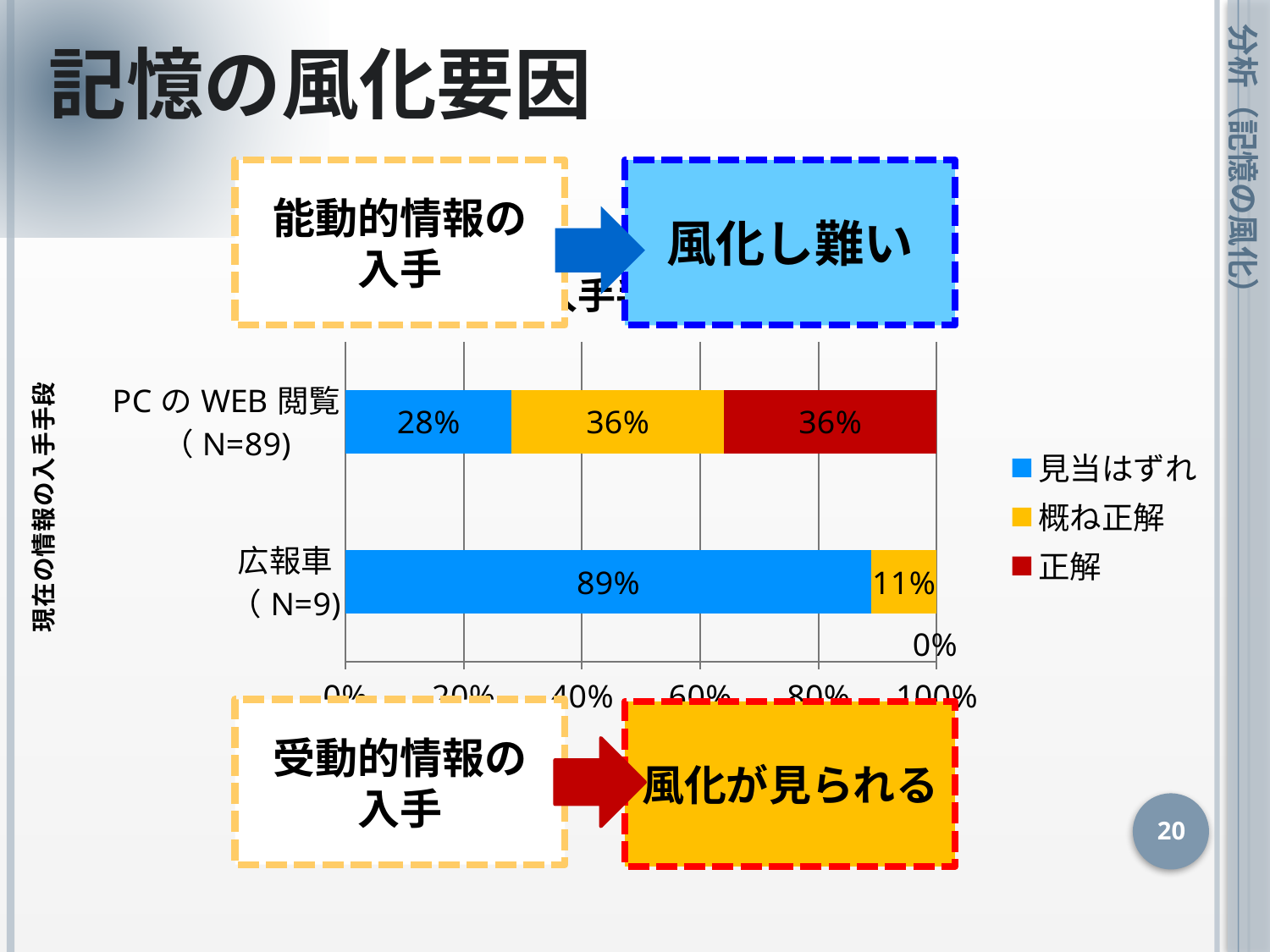
What percentage of 広報車 (N=9) respondents are 概ね正解? 11% What percentage of PCのWEB閲覧 (N=89) respondents are 正解? 36% Which legend entry is shown in red? 正解 Which category has the higher 見当はずれ share, PCのWEB閲覧 or 広報車? 広報車 What percentage of 広報車 (N=9) respondents are 見当はずれ? 89% How many series does the legend list? 3 What percentage of 広報車 (N=9) respondents are 正解? 0% What is the difference between the 見当はずれ share for 広報車 and for PCのWEB閲覧? 61% How many categories are shown on the chart? 2 What percentage of PCのWEB閲覧 (N=89) respondents are 見当はずれ? 28% What is the difference between the 概ね正解 share for PCのWEB閲覧 and for 広報車? 25% What kind of chart is shown on the slide? Stacked bar chart